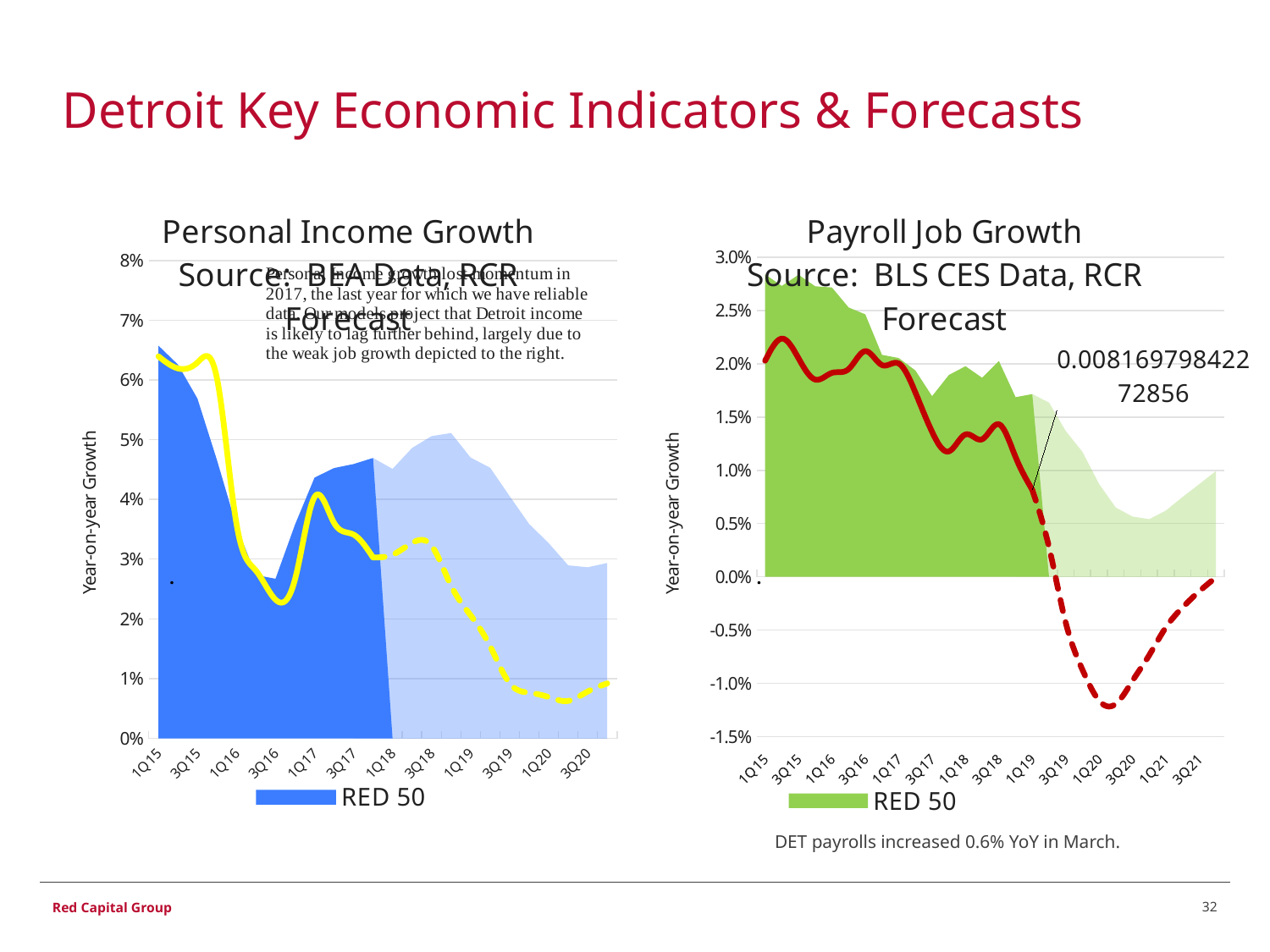
On the Payroll Job Growth chart, is the value of the green shaded area at 1Q15 greater or less than 2.5%? greater On the Payroll Job Growth chart, is the lowest point of the red dashed line greater or less than -1.0%? less On the Personal Income Growth chart, which is larger: the blue shaded area value at 1Q15 or at 3Q16? 1Q15 How many x-axis labels are shown on the Personal Income Growth chart? 12 On the Personal Income Growth chart, is the value of the yellow line at 3Q16 greater or less than 3%? less What is the y-axis title of the Payroll Job Growth chart? Year-on-year Growth What kind of chart is the Personal Income Growth chart on the left? combination area and line chart How many series does the legend of the Payroll Job Growth chart list? 1 What is the legend entry shown below the Personal Income Growth chart? RED 50 On the Payroll Job Growth chart, does the red line rise or fall between 1Q19 and 1Q20? fall How many x-axis labels are shown on the Payroll Job Growth chart? 14